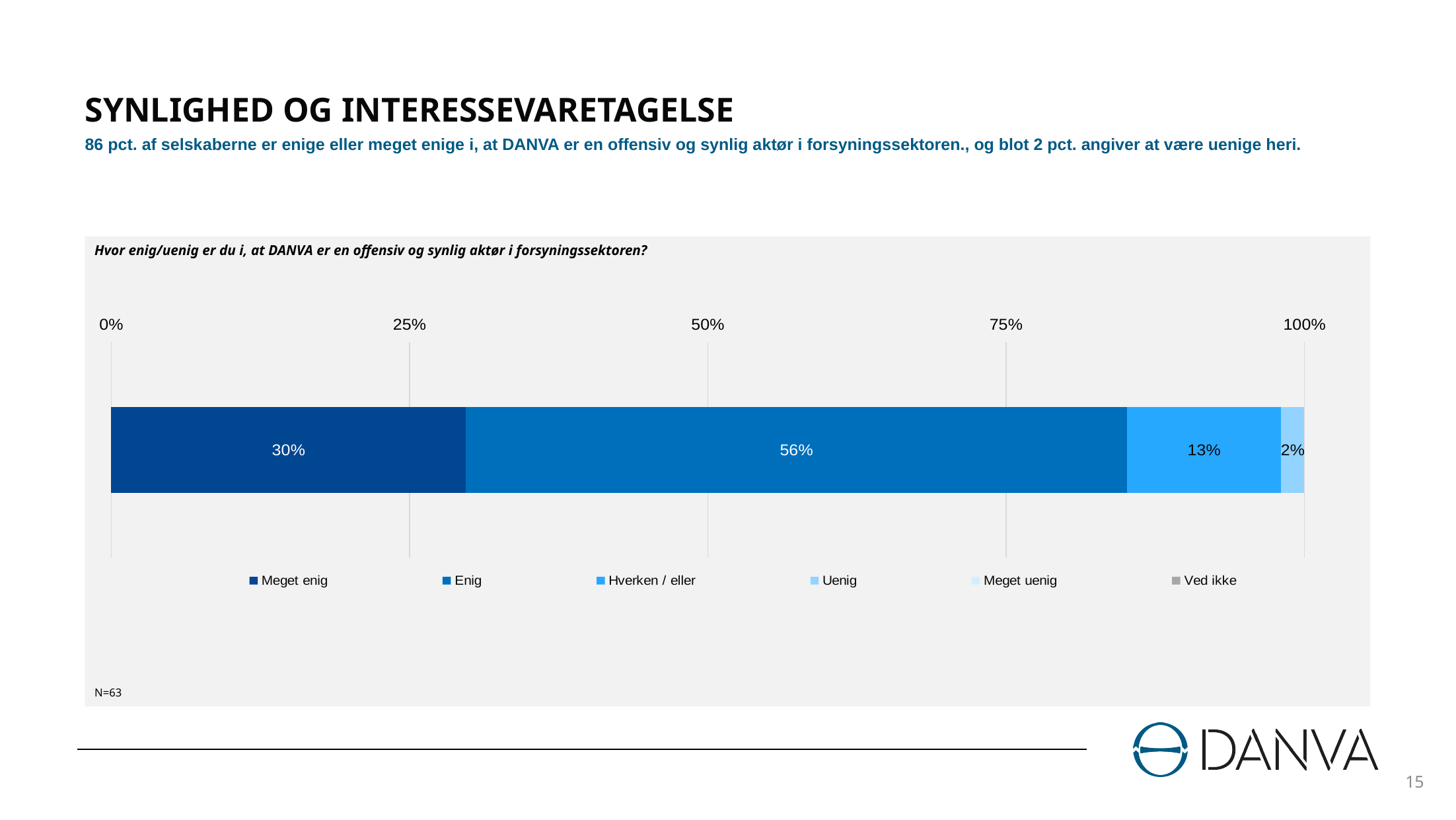
Which response category has the largest share in the bar? Enig What percentage of respondents answered "Uenig"? 2% What percentage of respondents answered "Enig"? 56% What kind of chart is shown on the slide? Stacked bar chart What percentage of respondents answered "Meget enig"? 30% Is the value for "Enig" greater or less than 50%? greater What is the difference in percentage points between "Enig" and "Meget enig"? 26 What is the combined share of "Meget enig" and "Enig"? 86% What percentage of respondents answered "Hverken / eller"? 13% Which labelled response category has the smallest share in the bar? Uenig How many series does the legend list? 6 Which is larger, the share for "Meget enig" or the share for "Hverken / eller"? Meget enig